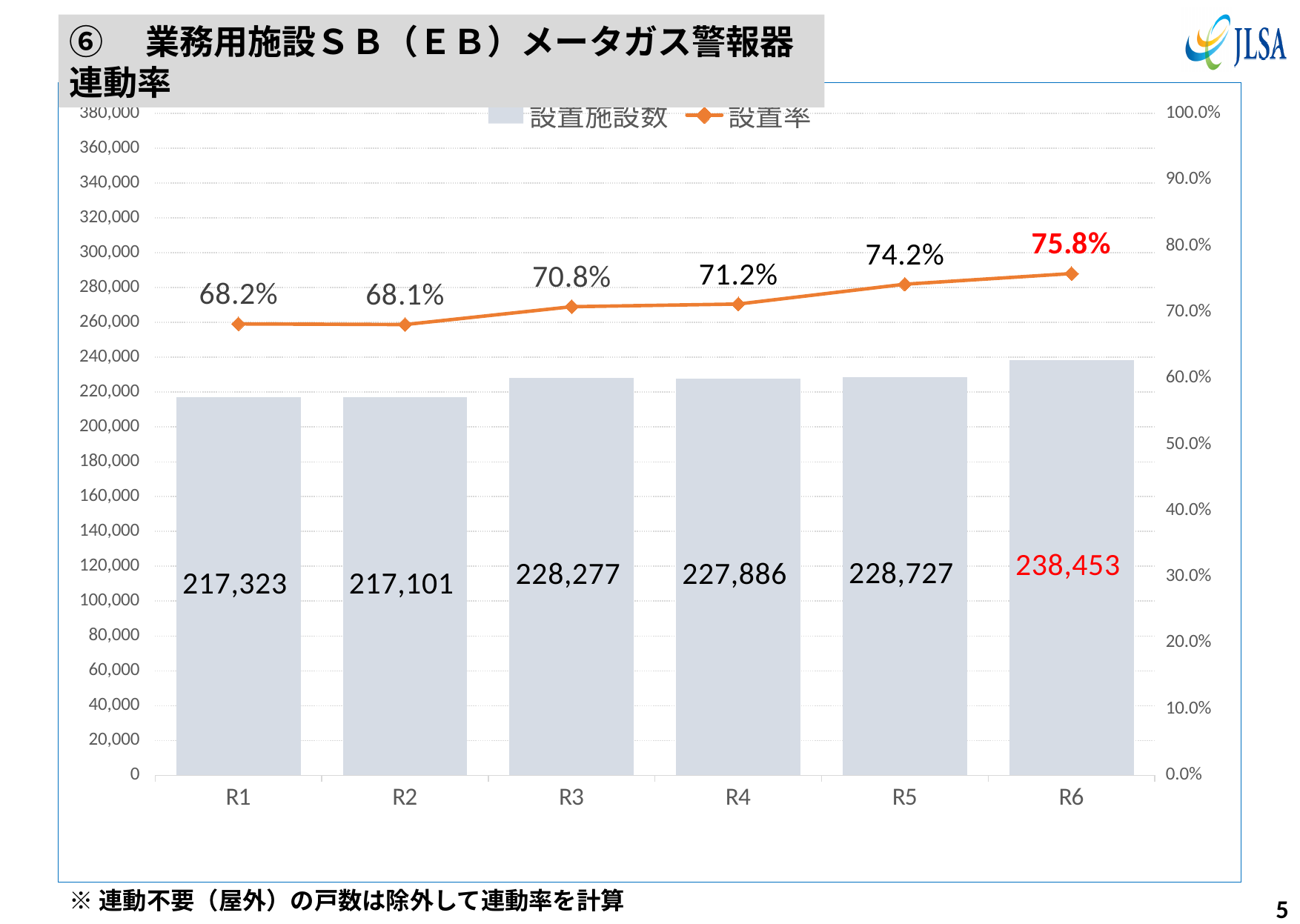
What is the 設置施設数 value for R6? 238,453 By how many percentage points did 設置率 increase from R1 to R6? 7.6 What is the 設置施設数 value for R1? 217,323 How many series does the legend list? 2 Which is larger, the 設置施設数 for R3 or for R4? R3 How many years are shown on the x axis? 6 Which year has the lowest 設置率? R2 What kind of chart is this? Combined bar and line chart What is the 設置率 value for R4? 71.2% What is the difference in 設置施設数 between R6 and R1? 21,130 Does the 設置率 line generally rise or fall from R1 to R6? Rise Which year has the highest 設置施設数? R6